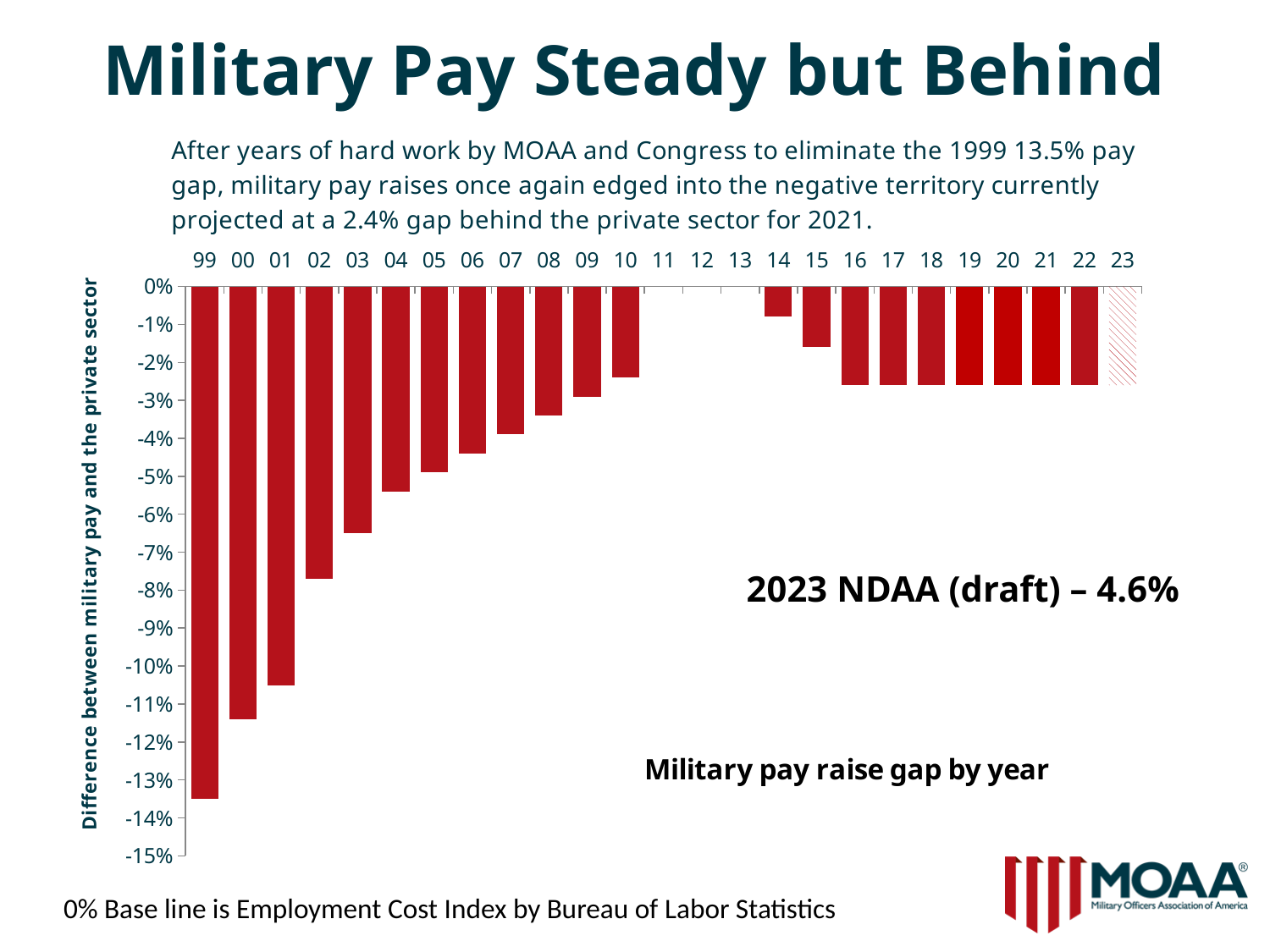
Which year has the larger (less negative) value, 03 or 04? 04 How many years are labelled along the x axis of the chart? 25 From 99 to 10, do the values rise or fall along the x axis? rise Is the value for 10 greater or less than -3%? greater Is the value for 99 greater or less than -10%? less Which year has the largest (most negative) pay gap in the chart? 99 Is the value for 14 greater or less than -1%? greater How many years on the x axis show no bar at all? 3 What is the label on the vertical axis of the chart? Difference between military pay and the private sector What kind of chart is shown on the slide? bar chart What is the title of the chart? Military pay raise gap by year